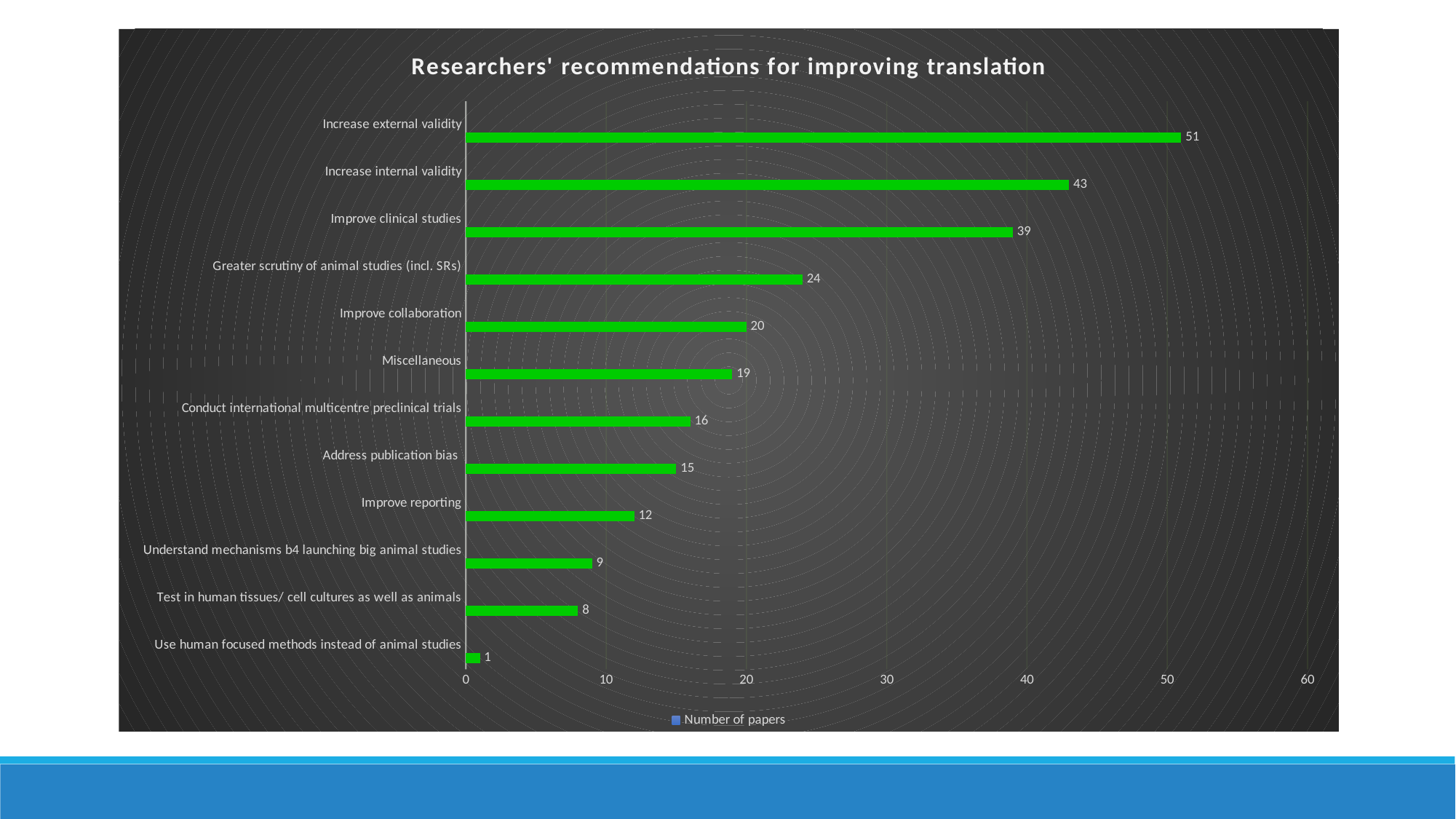
Which recommendation has the lowest number of papers? Use human focused methods instead of animal studies What is the title of the chart? Researchers' recommendations for improving translation What is the difference in number of papers between Increase external validity and Increase internal validity? 8 What is the number of papers for Increase external validity? 51 What type of chart is shown on the slide? Bar chart What is the number of papers for Improve collaboration? 20 Which has more papers, Improve reporting or Miscellaneous? Miscellaneous Is the value for Improve clinical studies greater or less than 30? greater What is the difference in number of papers between Improve clinical studies and Greater scrutiny of animal studies (incl. SRs)? 15 What is the number of papers for Address publication bias? 15 Which recommendation has the highest number of papers? Increase external validity How many recommendation categories are shown in the chart? 12